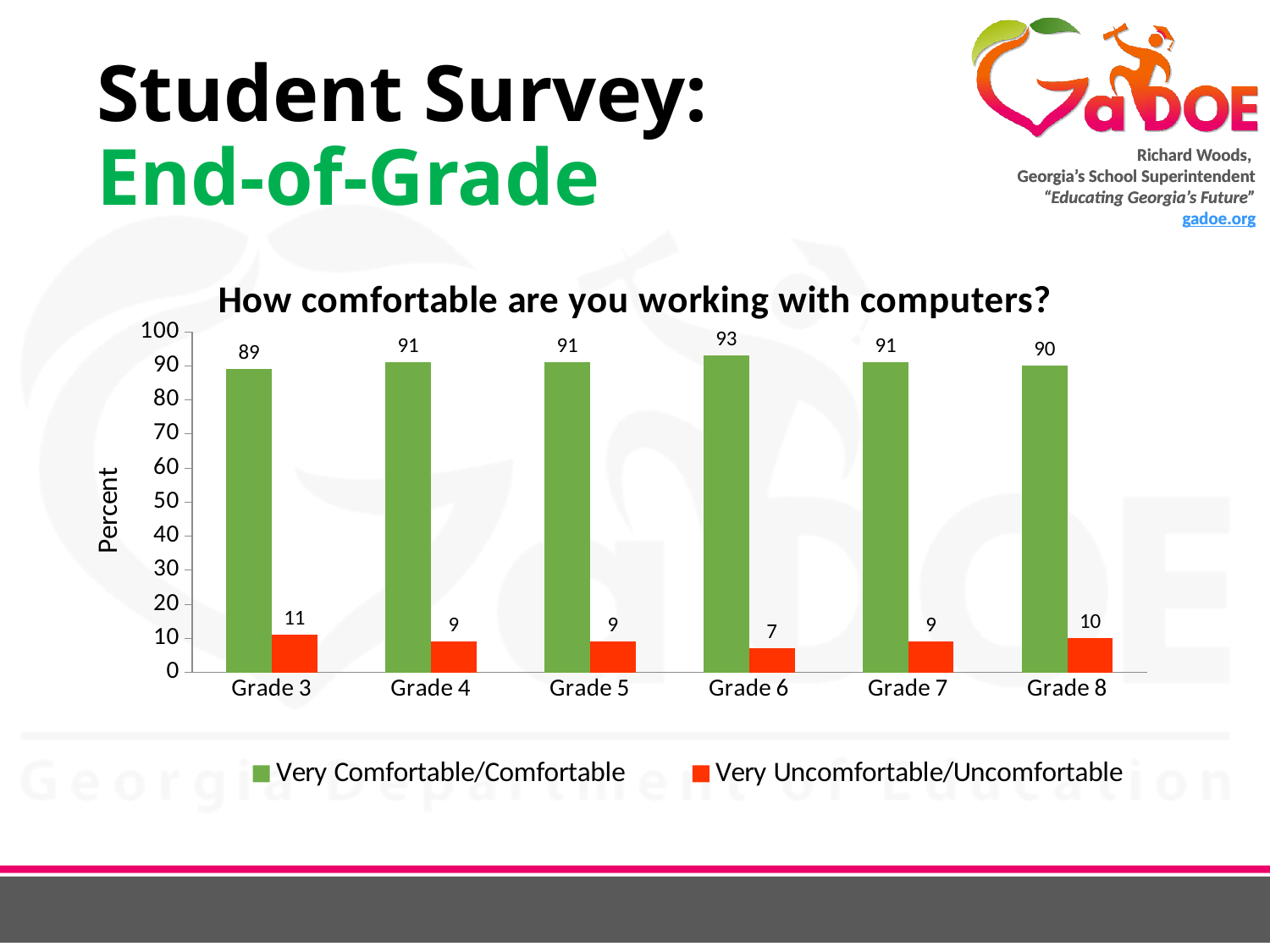
What is the Very Comfortable/Comfortable value for Grade 6? 93 Which grade has the lowest Very Uncomfortable/Uncomfortable value? Grade 6 Which grade has the lowest Very Comfortable/Comfortable value? Grade 3 What is the difference between the Very Comfortable/Comfortable values for Grade 6 and Grade 3? 4 Which is larger, the Very Uncomfortable/Uncomfortable value for Grade 3 or for Grade 8? Grade 3 What is the title of the chart? How comfortable are you working with computers? Which grade has the highest Very Comfortable/Comfortable value? Grade 6 What is the Very Comfortable/Comfortable value for Grade 8? 90 What is the Very Uncomfortable/Uncomfortable value for Grade 3? 11 How many grades are shown on the x axis? 6 What kind of chart is shown on the slide? Bar chart How many series does the legend list? 2